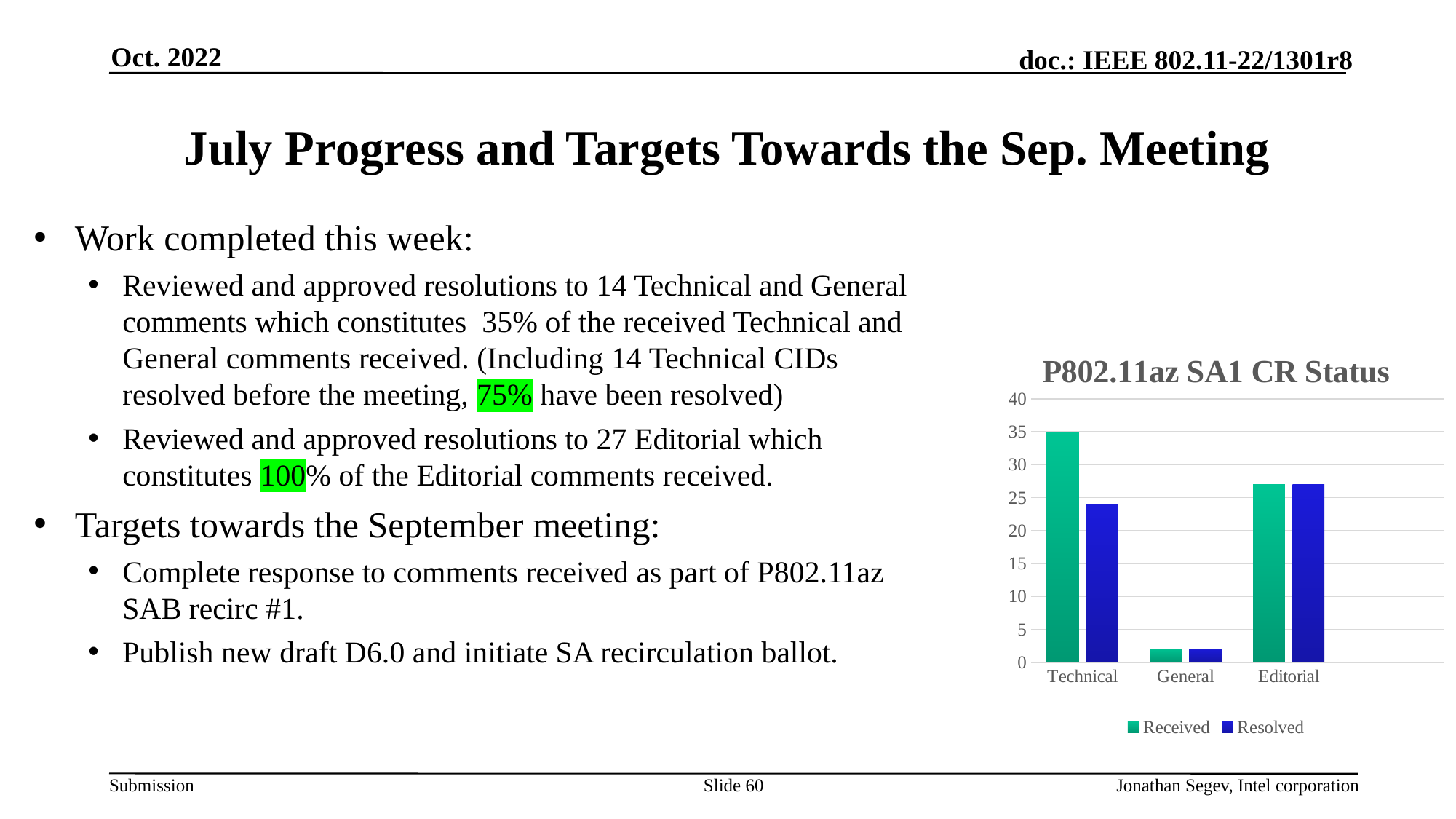
How many series does the chart's legend list? 2 What kind of chart is shown on the slide? bar chart For the Technical category, which is larger: Received or Resolved? Received How many categories are shown on the x axis of the chart? 3 Is the Received value for Technical greater or less than 30? greater Is the Resolved value for Technical greater or less than 20? greater What is the title of the chart? P802.11az SA1 CR Status Is the Received value for General greater or less than 5? less Which category has the highest Received value? Technical Which series is shown in blue in the chart's legend? Resolved Which category has the lowest Received value? General